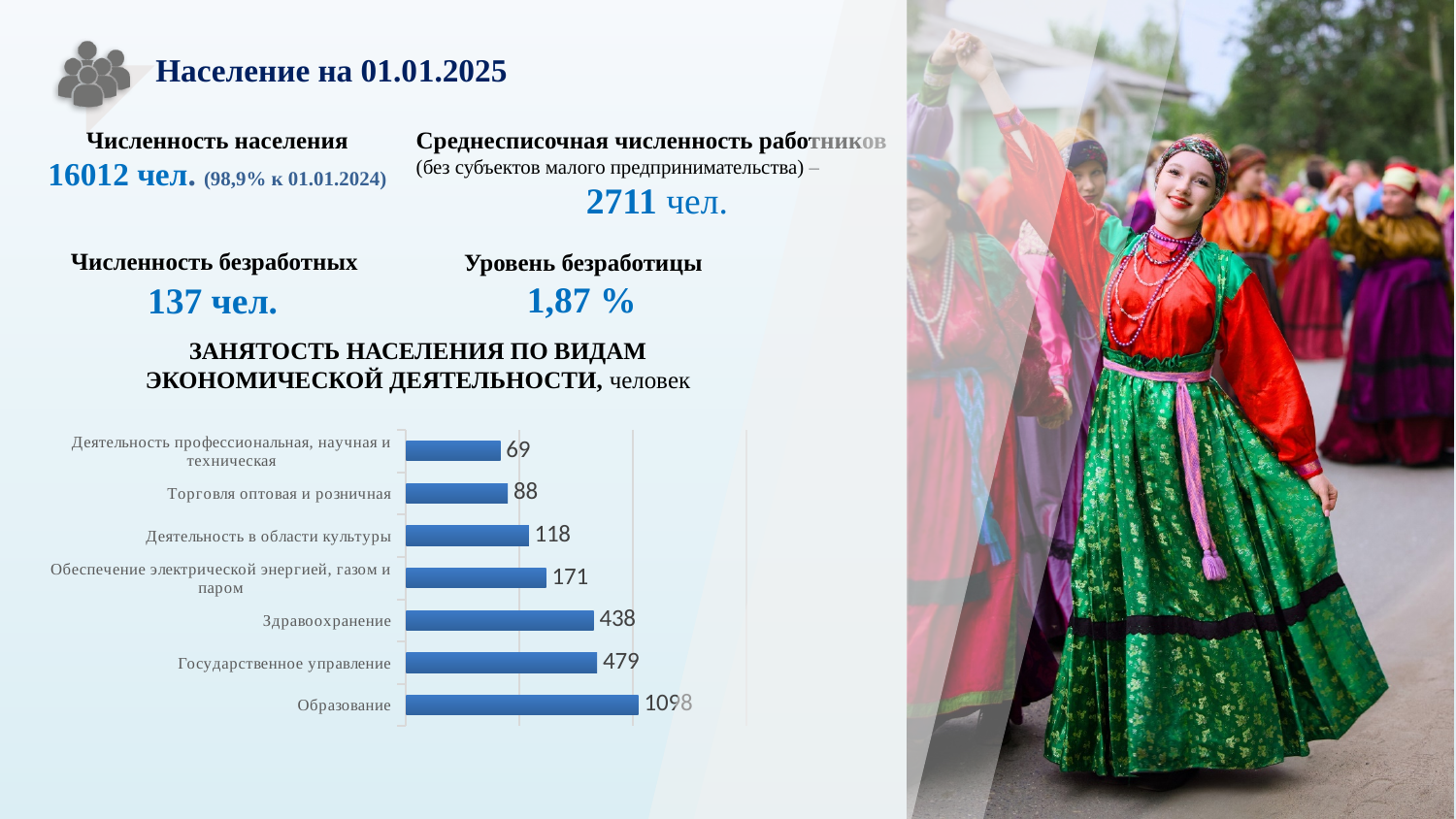
Which category has the lowest value? Деятельность профессиональная, научная и техническая What unit is stated in the chart title? человек What is the value for Торговля оптовая и розничная? 88 What kind of chart is shown on the slide? bar chart What is the value for Обеспечение электрической энергией, газом и паром? 171 What is the difference between the values for Деятельность в области культуры and Торговля оптовая и розничная? 30 What is the value for Образование? 1098 What is the value for Здравоохранение? 438 What is the difference between the values for Государственное управление and Здравоохранение? 41 Which category has the highest value? Образование How many categories are shown in the chart? 7 Which is larger, the value for Здравоохранение or the value for Обеспечение электрической энергией, газом и паром? Здравоохранение